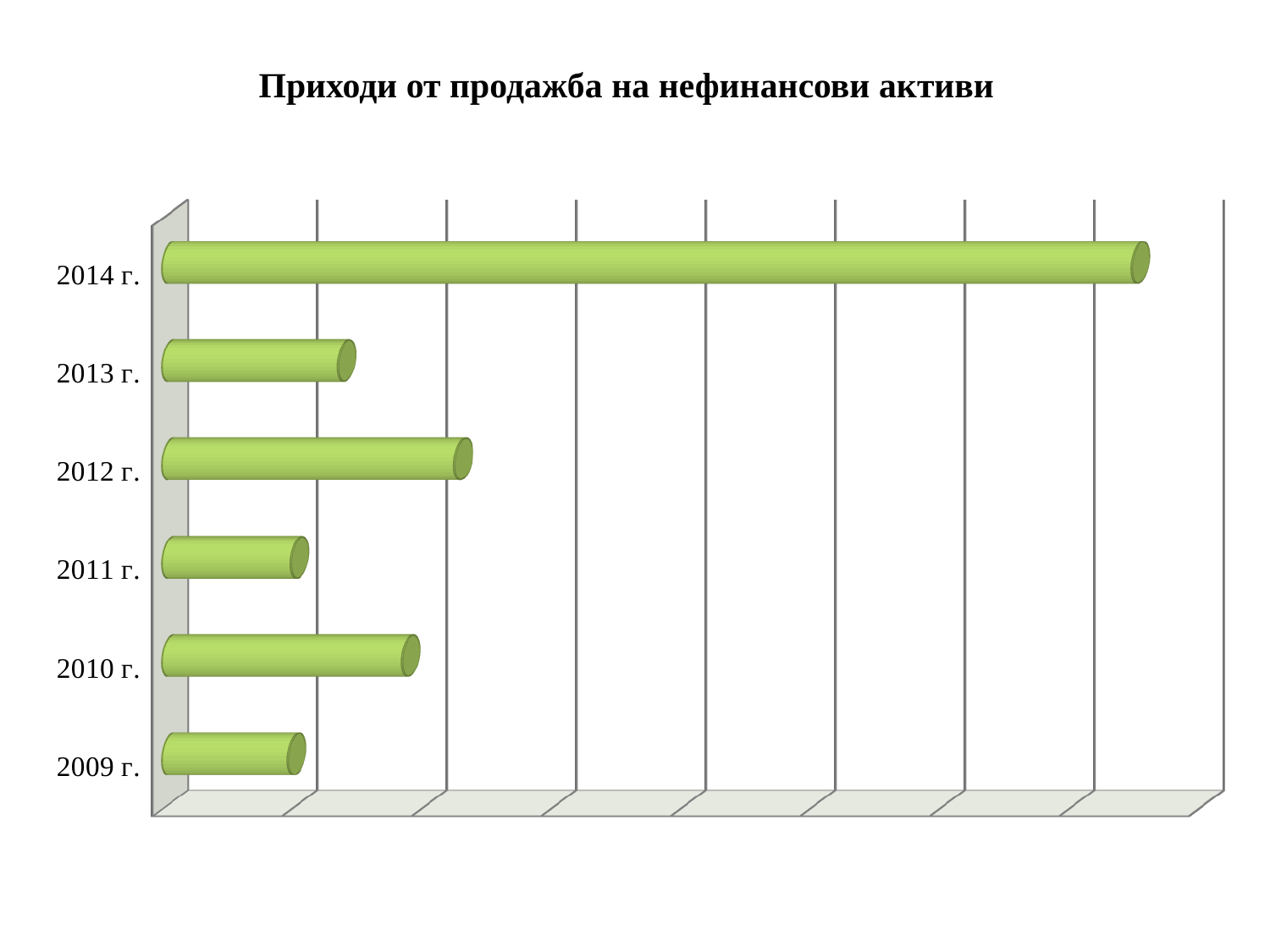
What kind of chart is shown on the slide? bar chart Which is larger, the value for 2013 г. or the value for 2011 г.? 2013 г. Does the value rise or fall from 2013 г. to 2014 г.? rise How many years (categories) are shown in the chart? 6 Which year has the highest value in the chart? 2014 г. What is the title of the chart? Приходи от продажба на нефинансови активи Which is larger, the value for 2012 г. or the value for 2010 г.? 2012 г. What colour are the bars in the chart? green Does the value rise or fall from 2012 г. to 2013 г.? fall Which is larger, the value for 2012 г. or the value for 2013 г.? 2012 г.